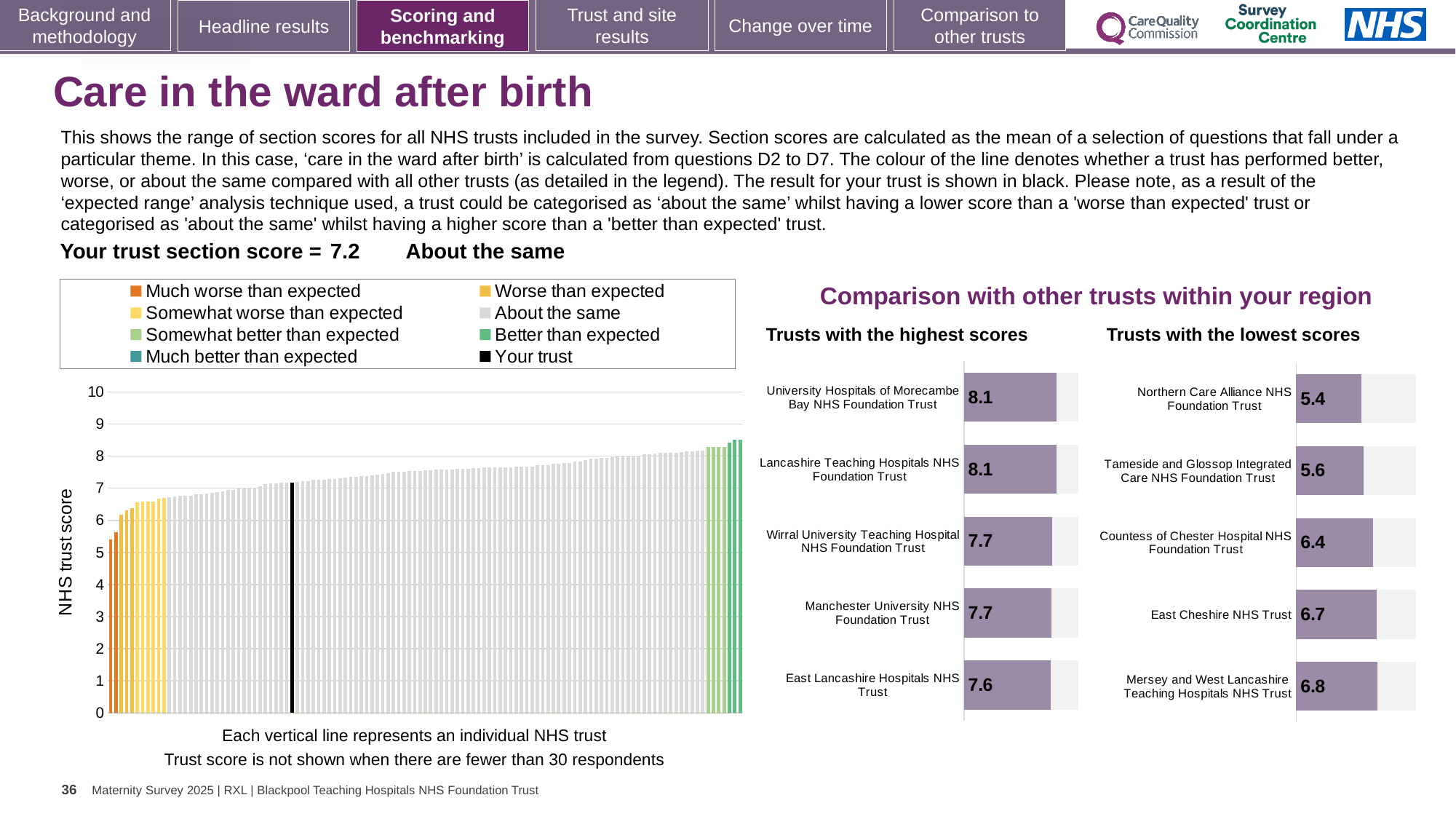
In the main NHS trust score chart on the left, do the bar values rise or fall from left to right? rise In the main NHS trust score chart on the left, is the value of the tallest bar greater or less than 8? greater In the 'Trusts with the lowest scores' chart, which trust has the lowest score? Northern Care Alliance NHS Foundation Trust In the 'Trusts with the lowest scores' chart, what is the score for Northern Care Alliance NHS Foundation Trust? 5.4 How many trusts are listed in the 'Trusts with the highest scores' chart? 5 What kind of chart is the main NHS trust score chart on the left? bar chart In the 'Trusts with the highest scores' chart, what is the score for East Lancashire Hospitals NHS Trust? 7.6 In the 'Trusts with the highest scores' chart, what is the score for University Hospitals of Morecambe Bay NHS Foundation Trust? 8.1 How many entries does the legend above the main NHS trust score chart list? 8 In the 'Trusts with the highest scores' chart, which has the larger score: Wirral University Teaching Hospital NHS Foundation Trust or East Lancashire Hospitals NHS Trust? Wirral University Teaching Hospital NHS Foundation Trust In the 'Trusts with the lowest scores' chart, which trust has the highest score? Mersey and West Lancashire Teaching Hospitals NHS Trust In the 'Trusts with the lowest scores' chart, what is the difference between the scores of Countess of Chester Hospital NHS Foundation Trust and Tameside and Glossop Integrated Care NHS Foundation Trust? 0.8